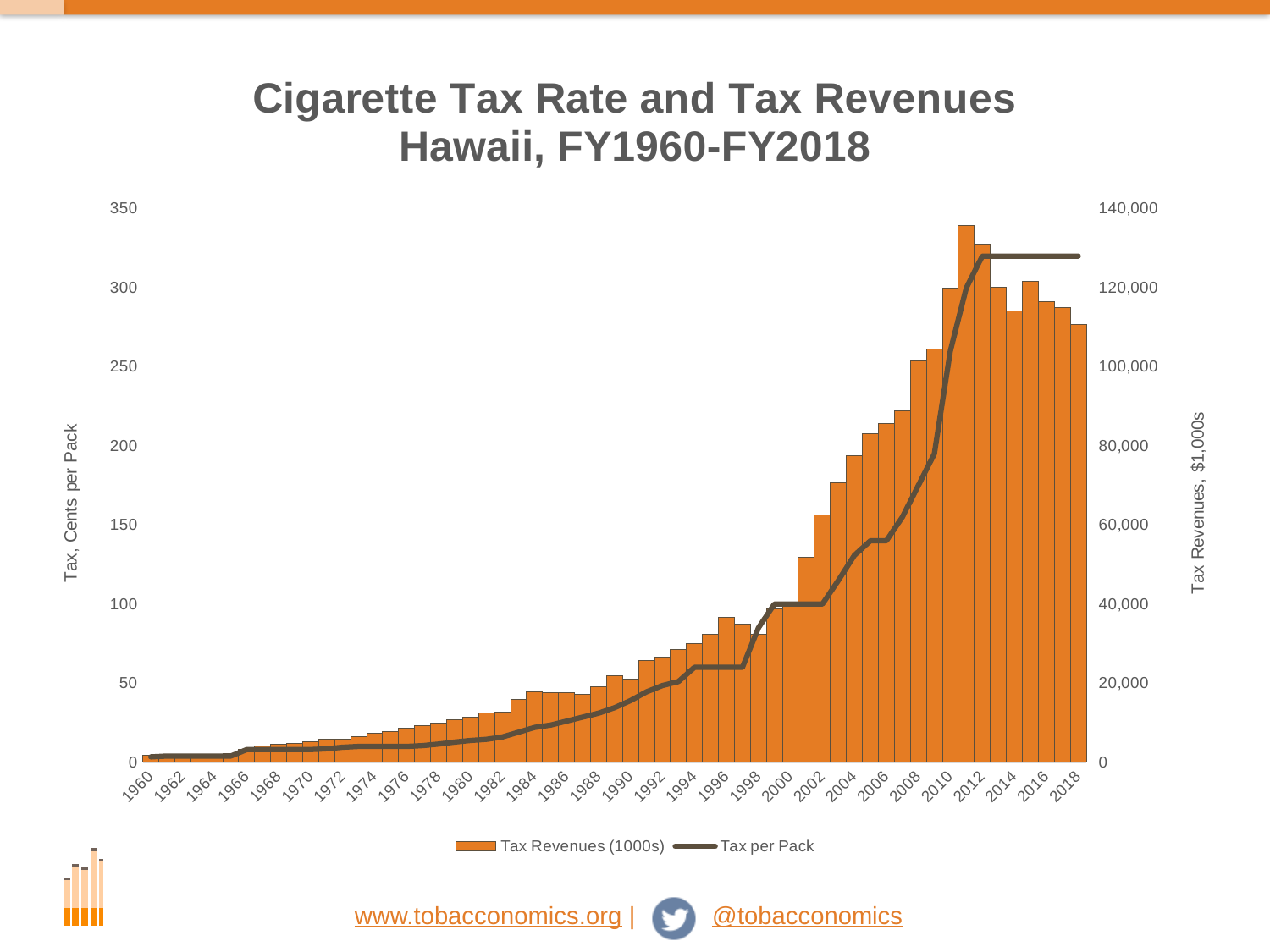
Is the Tax per Pack value for 2018 greater or less than 300? greater How many years (bars) are plotted on the x axis from 1960 to 2018? 59 What are the two series named in the legend? Tax Revenues (1000s) and Tax per Pack What is the label of the left vertical axis? Tax, Cents per Pack Is the Tax per Pack value for 1990 greater or less than 50? less Does the Tax per Pack line generally rise or fall from 1960 to 2018? rise In which year is the Tax Revenues bar the highest? 2011 What kind of chart is shown on the slide? A combined bar and line chart Is the Tax Revenues value for 1990 greater or less than 40,000? less How many series does the legend list? 2 Which year has the larger Tax Revenues bar, 2012 or 2018? 2012